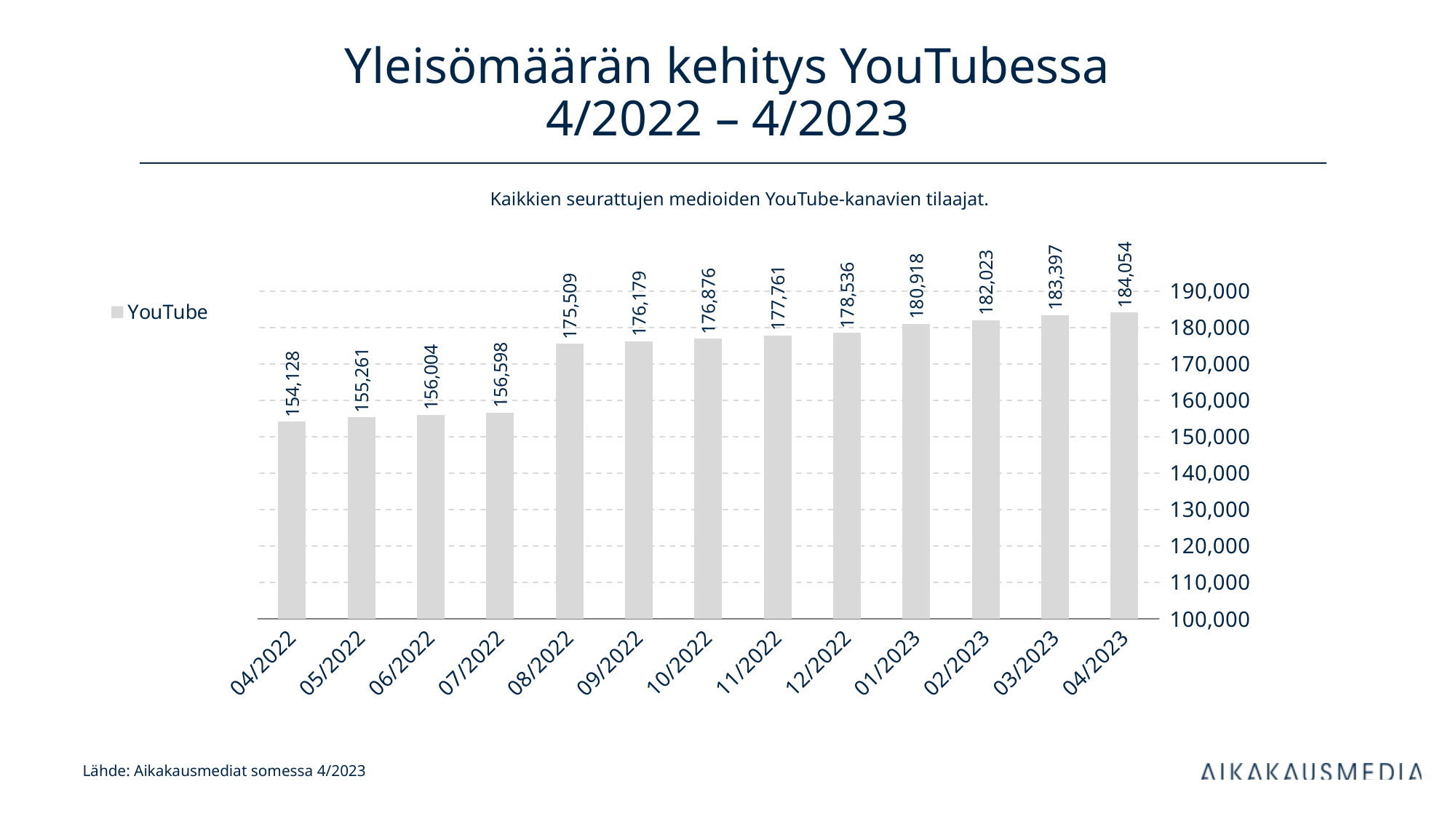
What kind of chart is shown on the slide? bar chart Is the value for 07/2022 greater or less than 160,000? less What is the difference between the values for 04/2023 and 04/2022? 29,926 Which month has the lowest value? 04/2022 Which month has the highest value? 04/2023 Which is larger, the value for 12/2022 or the value for 02/2023? 02/2023 What is the difference between the values for 08/2022 and 07/2022? 18,911 What is the value for 04/2022? 154,128 What is the value for 01/2023? 180,918 How many months are shown on the x axis? 13 Do the values rise or fall from 04/2022 to 04/2023? rise What is the value for 08/2022? 175,509